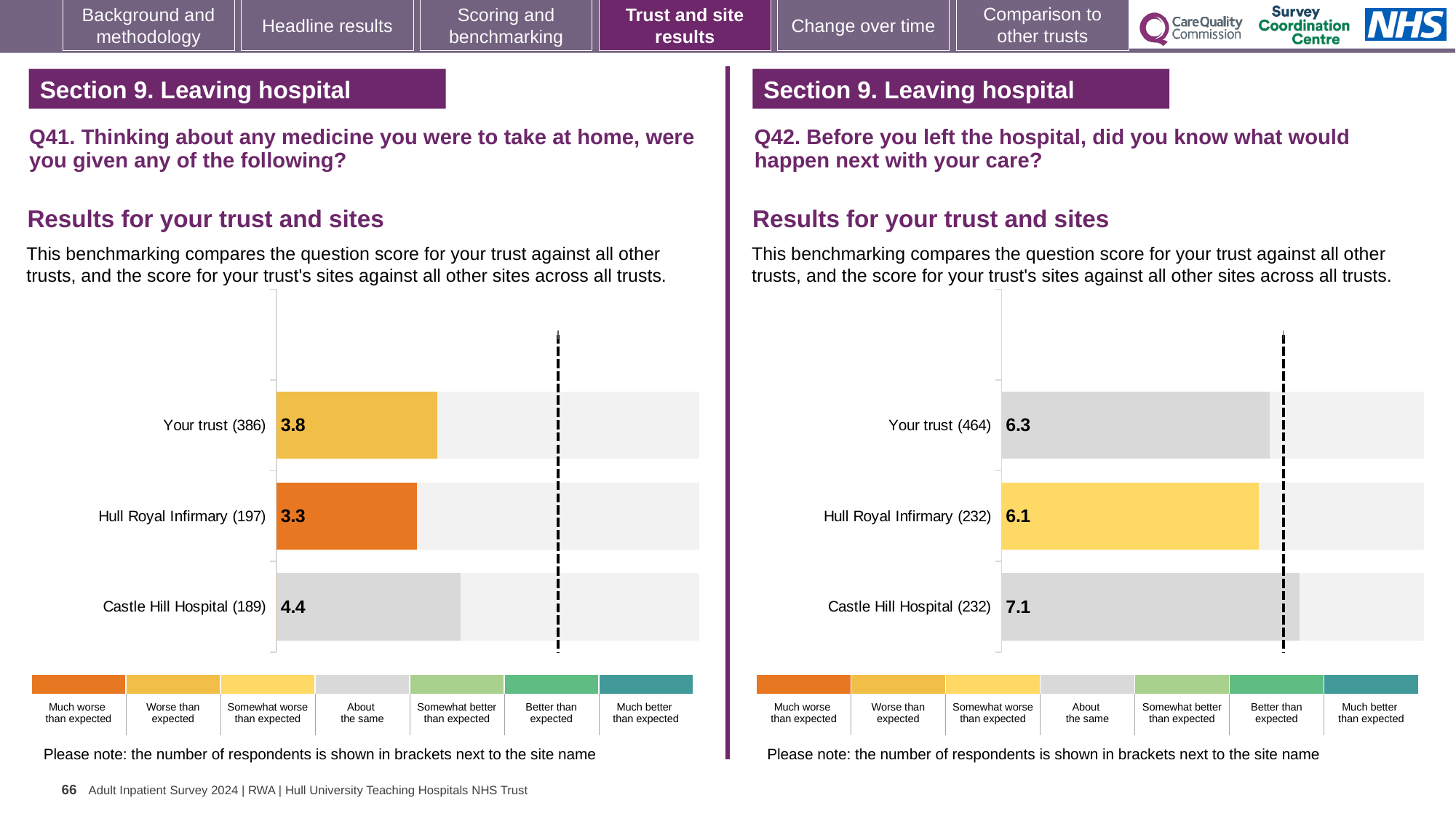
On the Q41 chart (left), what is the score for Your trust? 3.8 On the Q41 chart (left), how many respondents are shown in brackets for Castle Hill Hospital? 189 On the Q42 chart (right), what is the score for Castle Hill Hospital? 7.1 On the Q41 chart (left), what is the score for Hull Royal Infirmary? 3.3 On the Q41 chart (left), which site or trust has the highest score? Castle Hill Hospital On the Q42 chart (right), what is the score for Your trust? 6.3 On the Q41 chart (left), which site or trust has the lowest score? Hull Royal Infirmary On the Q41 chart (left), what is the difference between the scores for Castle Hill Hospital and Hull Royal Infirmary? 1.1 On the Q42 chart (right), which has the larger score, Hull Royal Infirmary or Castle Hill Hospital? Castle Hill Hospital What kind of chart is used on the Q41 chart (left)? Bar chart On the Q42 chart (right), what is the difference between the scores for Castle Hill Hospital and Your trust? 0.8 How many bars are plotted on the Q42 chart (right)? 3